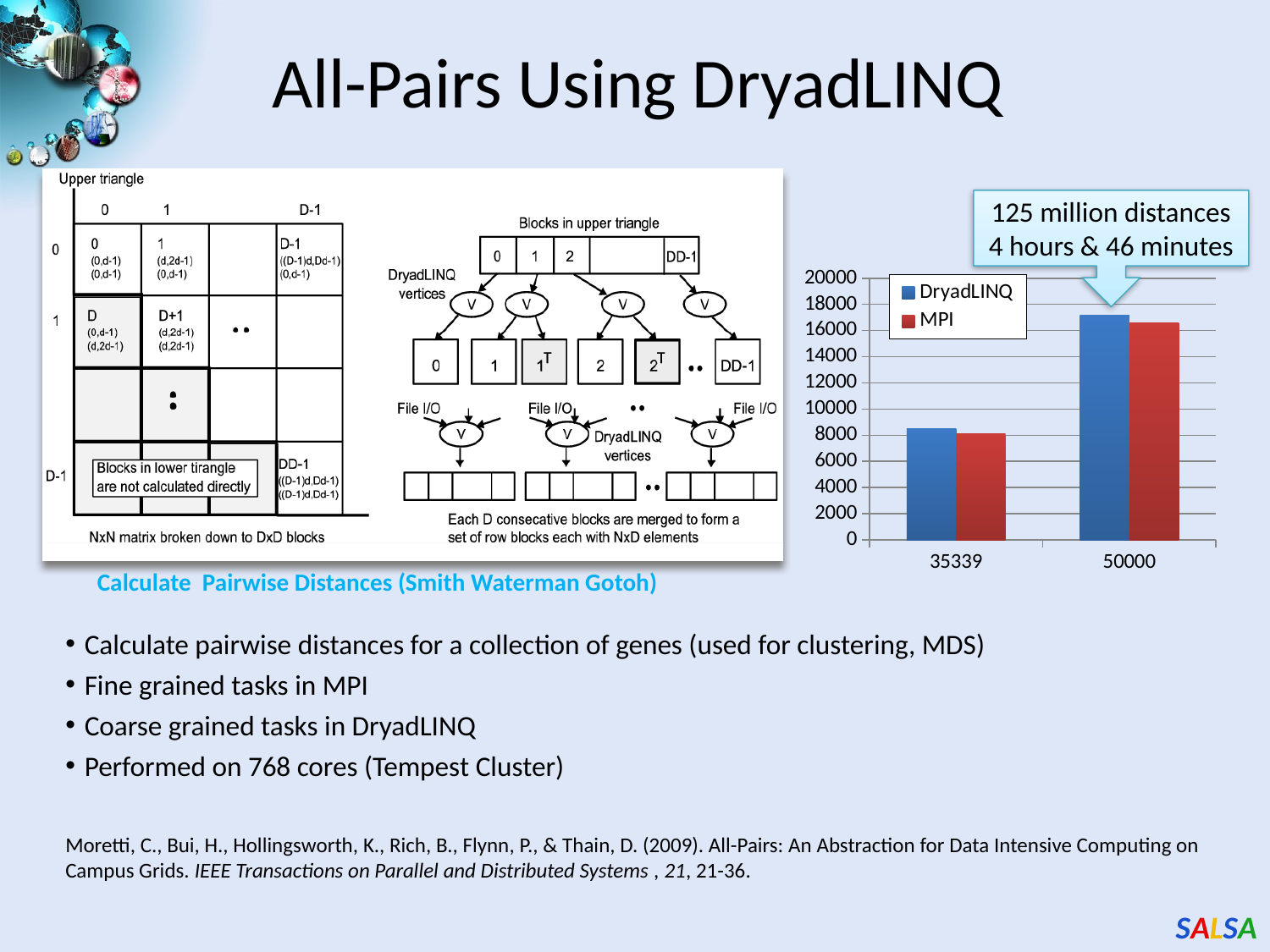
How many categories are shown on the x axis of the chart? 2 How many series does the chart's legend list? 2 Which category has the higher DryadLINQ value, 35339 or 50000? 50000 What are the two series named in the chart's legend? DryadLINQ and MPI Is the DryadLINQ value for 50000 greater or less than 16000? greater Is the MPI value for 35339 greater or less than 10000? less For the 50000 category, which series has the larger value, DryadLINQ or MPI? DryadLINQ Which category has the lowest MPI value? 35339 Do the DryadLINQ values rise or fall from 35339 to 50000? rise What kind of chart is shown on the slide? bar chart Is the DryadLINQ value for 35339 greater or less than 8000? greater